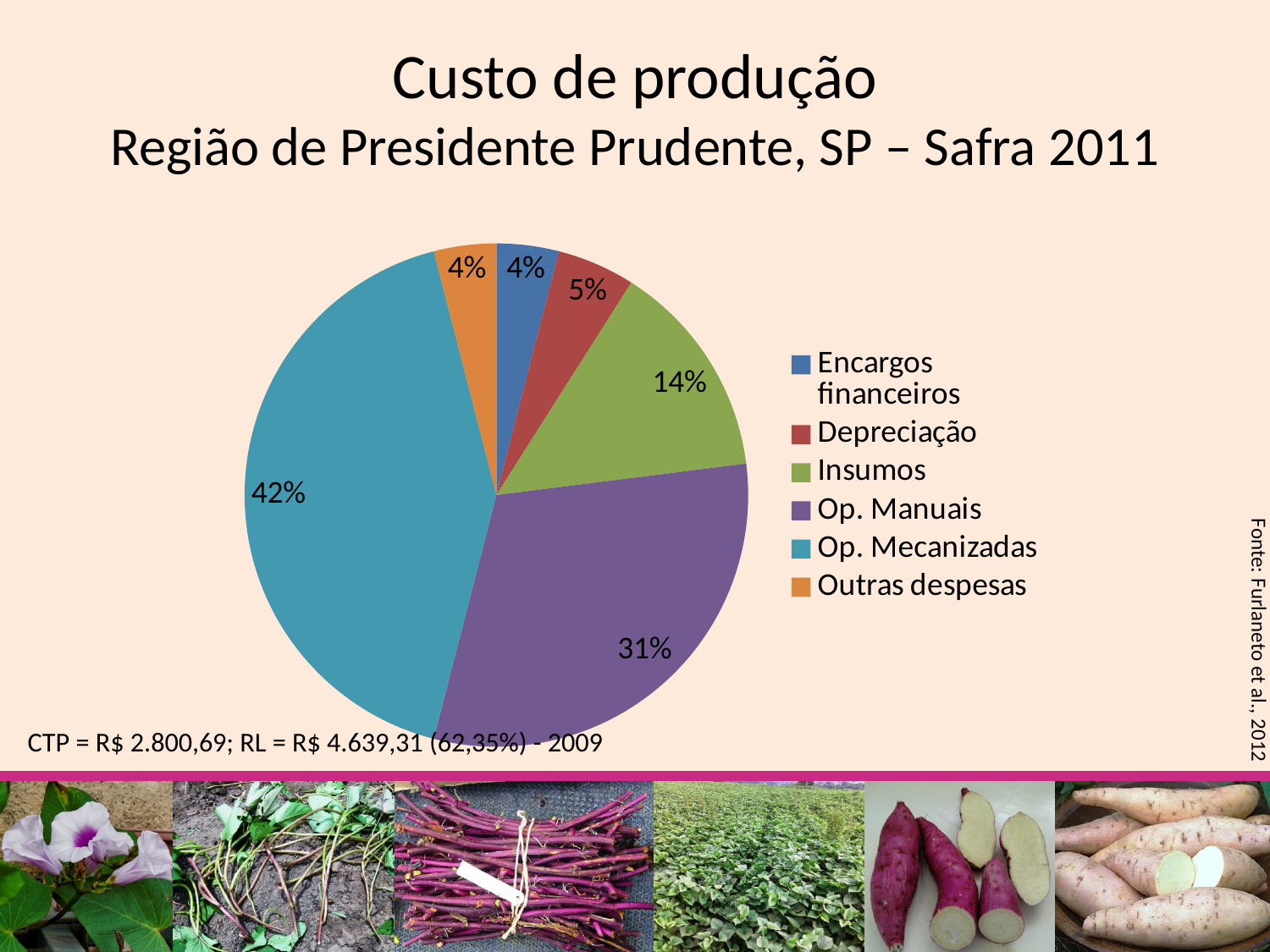
Which is larger, the share for Insumos or the share for Depreciação? Insumos What colour is the slice for Outras despesas? Orange What share of the production cost is Op. Manuais? 31% What is the difference in percentage points between Op. Mecanizadas and Op. Manuais? 11 What kind of chart is shown on the slide? Pie chart How many categories does the legend list? 6 What share of the production cost is Encargos financeiros? 4% What is the combined share of Op. Mecanizadas and Op. Manuais? 73% Which category has the largest share of the production cost? Op. Mecanizadas What share of the production cost is Insumos? 14% What share of the production cost is Op. Mecanizadas? 42% What share of the production cost is Depreciação? 5%